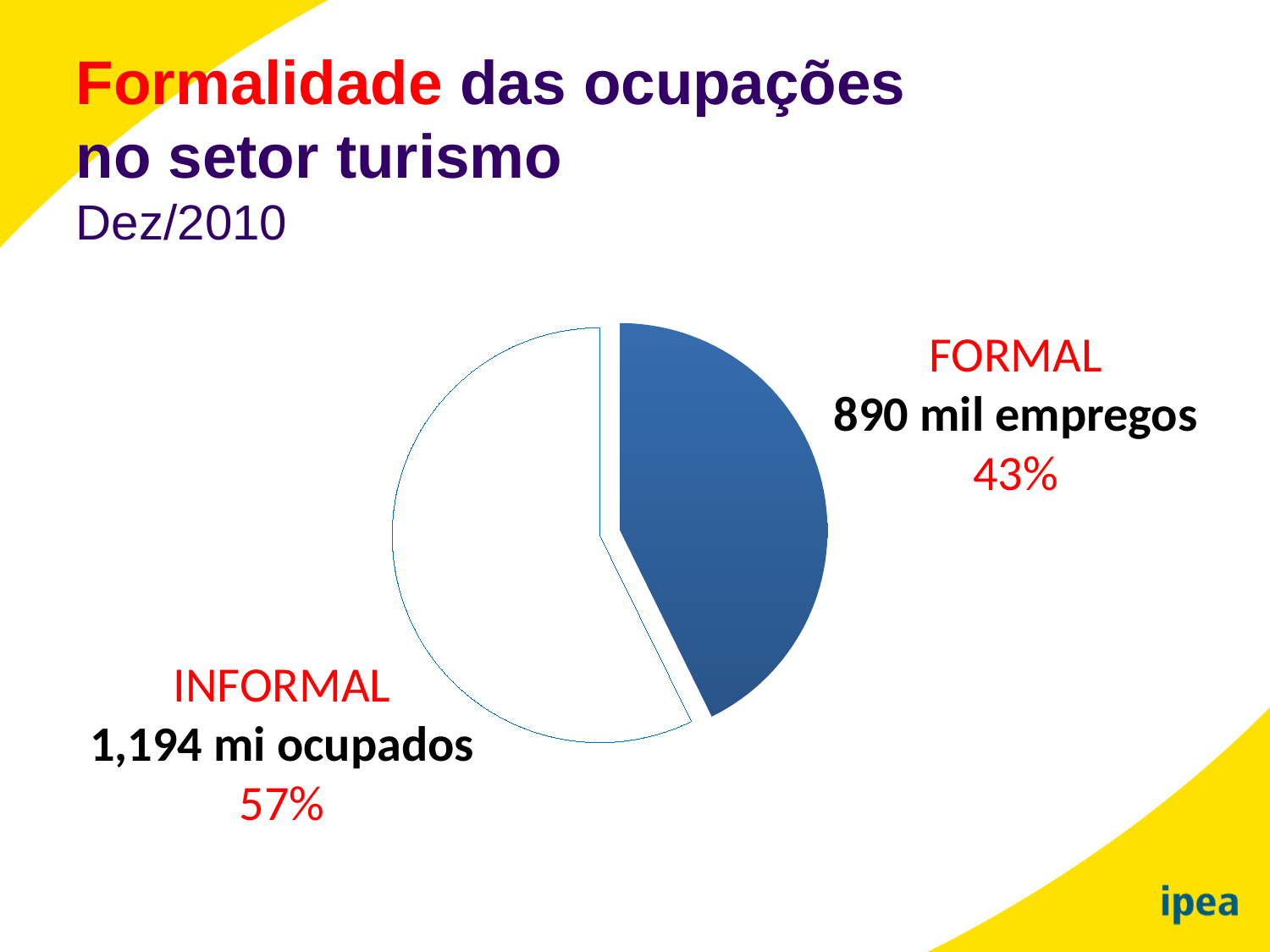
What share of the pie does the FORMAL slice represent? 43% Which category has the smallest share of the pie? FORMAL Which category has the largest share of the pie? INFORMAL How many jobs are labelled for the FORMAL slice? 890 mil empregos How many occupied workers are labelled for the INFORMAL slice? 1,194 mi ocupados Is the FORMAL share greater or less than 50%? less What colour is the FORMAL slice of the pie? blue What kind of chart is shown on the slide? pie chart What is the difference in percentage points between the INFORMAL and FORMAL shares? 14 What share of the pie does the INFORMAL slice represent? 57% Which slice is larger, FORMAL or INFORMAL? INFORMAL How many slices does the pie chart have? 2